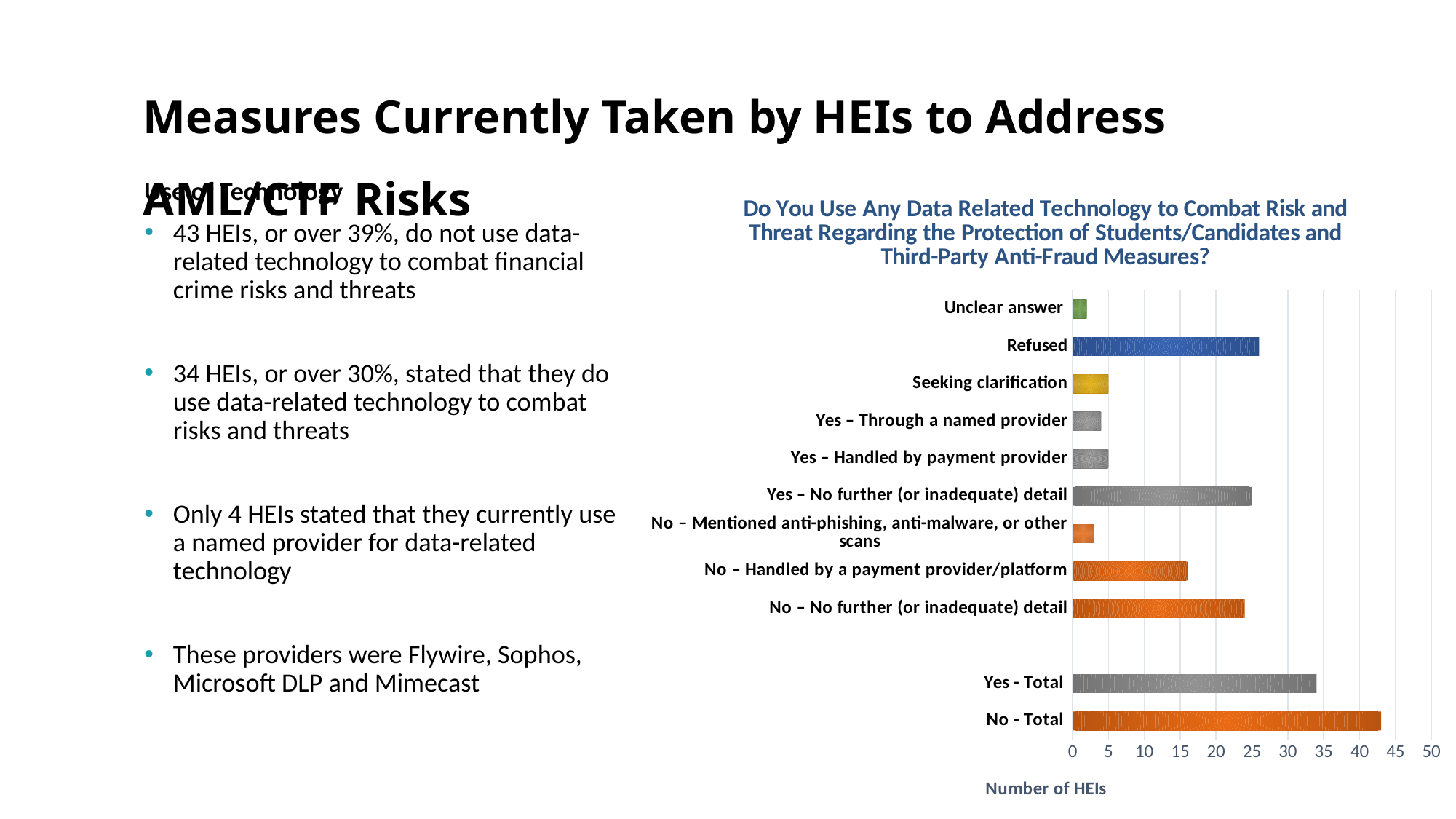
What kind of chart is shown on the slide? bar chart Is the value for 'Refused' greater or less than 20? greater Which category has the highest number of HEIs? No - Total What is the label of the horizontal axis of the chart? Number of HEIs Which is larger, the value for 'Refused' or the value for 'Seeking clarification'? Refused Which category has the lowest number of HEIs? Unclear answer Is the value for 'No – Handled by a payment provider/platform' greater or less than 10? greater How many HEIs are in the 'Yes – Through a named provider' category? 4 How many HEIs are in the 'No - Total' category? 43 How many HEIs are in the 'Yes - Total' category? 34 Is the value for 'Yes – No further (or inadequate) detail' greater or less than 20? greater How many categories are plotted in the chart? 11